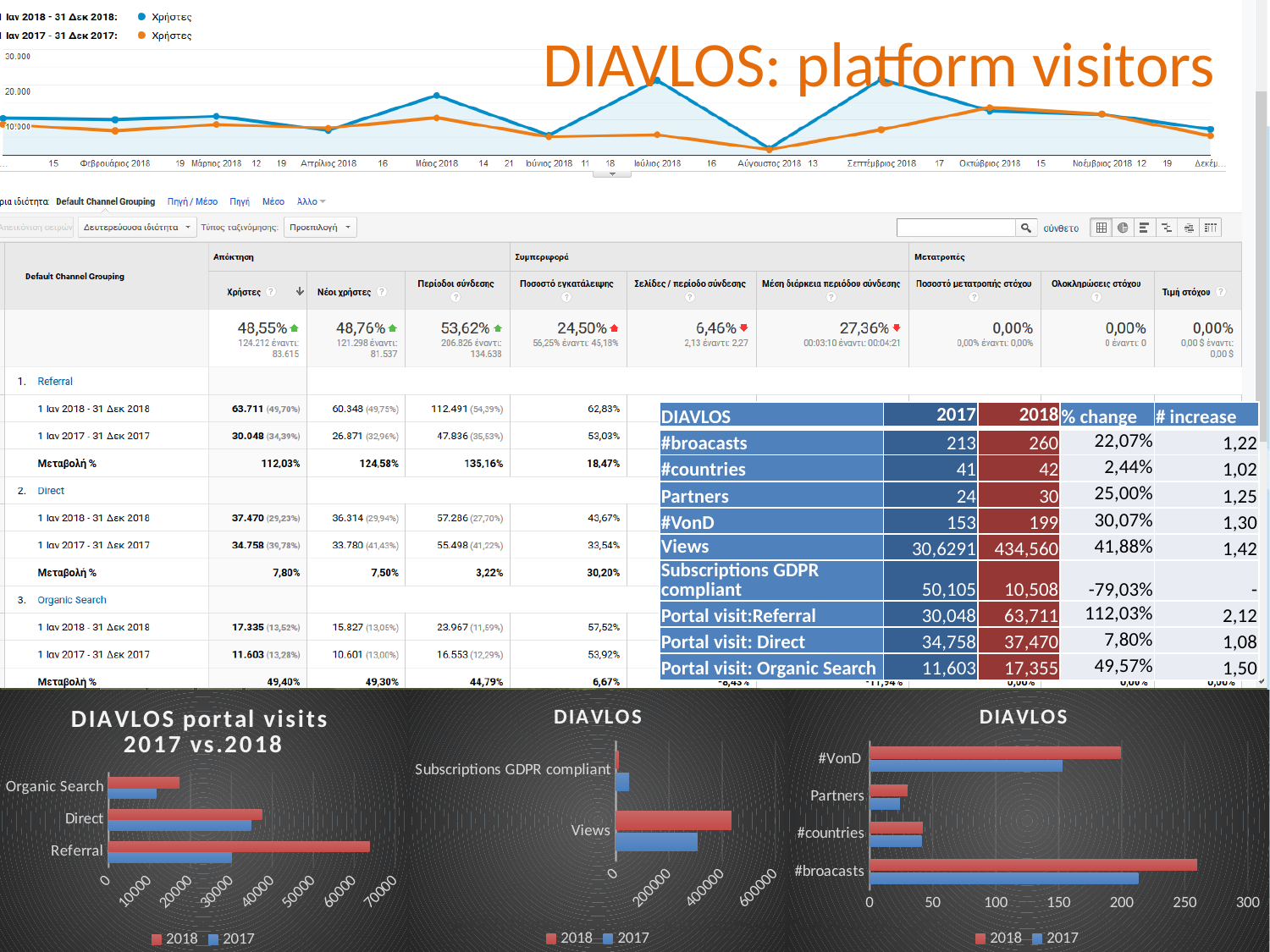
In the 'DIAVLOS' chart at the bottom right, is the 2018 value for #VonD greater or less than 150? greater What kind of chart is the 'DIAVLOS portal visits 2017 vs.2018' chart at the bottom left? bar chart In the 'DIAVLOS portal visits 2017 vs.2018' chart, is the 2018 value for Referral greater or less than 60000? greater How many categories are shown in the 'DIAVLOS portal visits 2017 vs.2018' chart? 3 In the middle 'DIAVLOS' chart at the bottom, is the 2018 value for Views greater or less than 400000? greater In the 'DIAVLOS portal visits 2017 vs.2018' chart, which category has the highest 2018 value? Referral In the 'DIAVLOS' chart at the bottom right, which category has the highest 2018 value? #broacasts In the 'DIAVLOS' chart at the bottom right, which colour represents the 2018 series? red How many series does the legend of the 'DIAVLOS portal visits 2017 vs.2018' chart list? 2 In the middle 'DIAVLOS' chart at the bottom, which is larger for Subscriptions GDPR compliant, 2018 or 2017? 2017 In the 'DIAVLOS portal visits 2017 vs.2018' chart, which is larger for Referral, 2018 or 2017? 2018